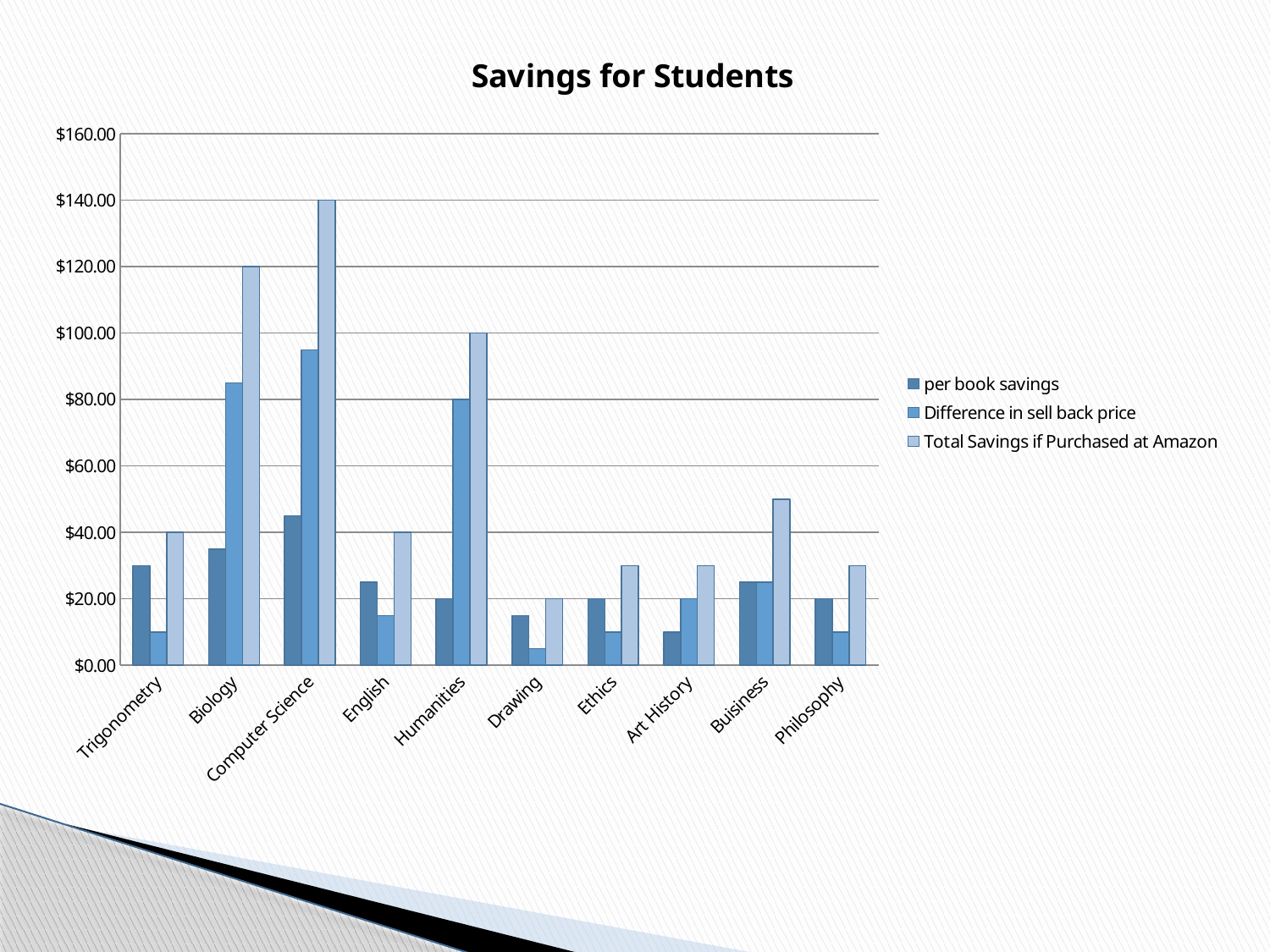
Is the Total Savings if Purchased at Amazon for Buisiness greater or less than $40.00? greater How many course categories are shown on the x axis? 10 What is the Total Savings if Purchased at Amazon for Biology? $120.00 How many series does the legend list? 3 What is the title of the chart? Savings for Students Which category has the lowest Difference in sell back price? Drawing Which is larger, the Total Savings if Purchased at Amazon for Biology or for Humanities? Biology What kind of chart is shown on the slide? bar chart What is the difference between the Total Savings if Purchased at Amazon for Computer Science and for Biology? $20.00 What is the Total Savings if Purchased at Amazon for Computer Science? $140.00 Which category has the highest Total Savings if Purchased at Amazon? Computer Science What is the Difference in sell back price for Humanities? $80.00